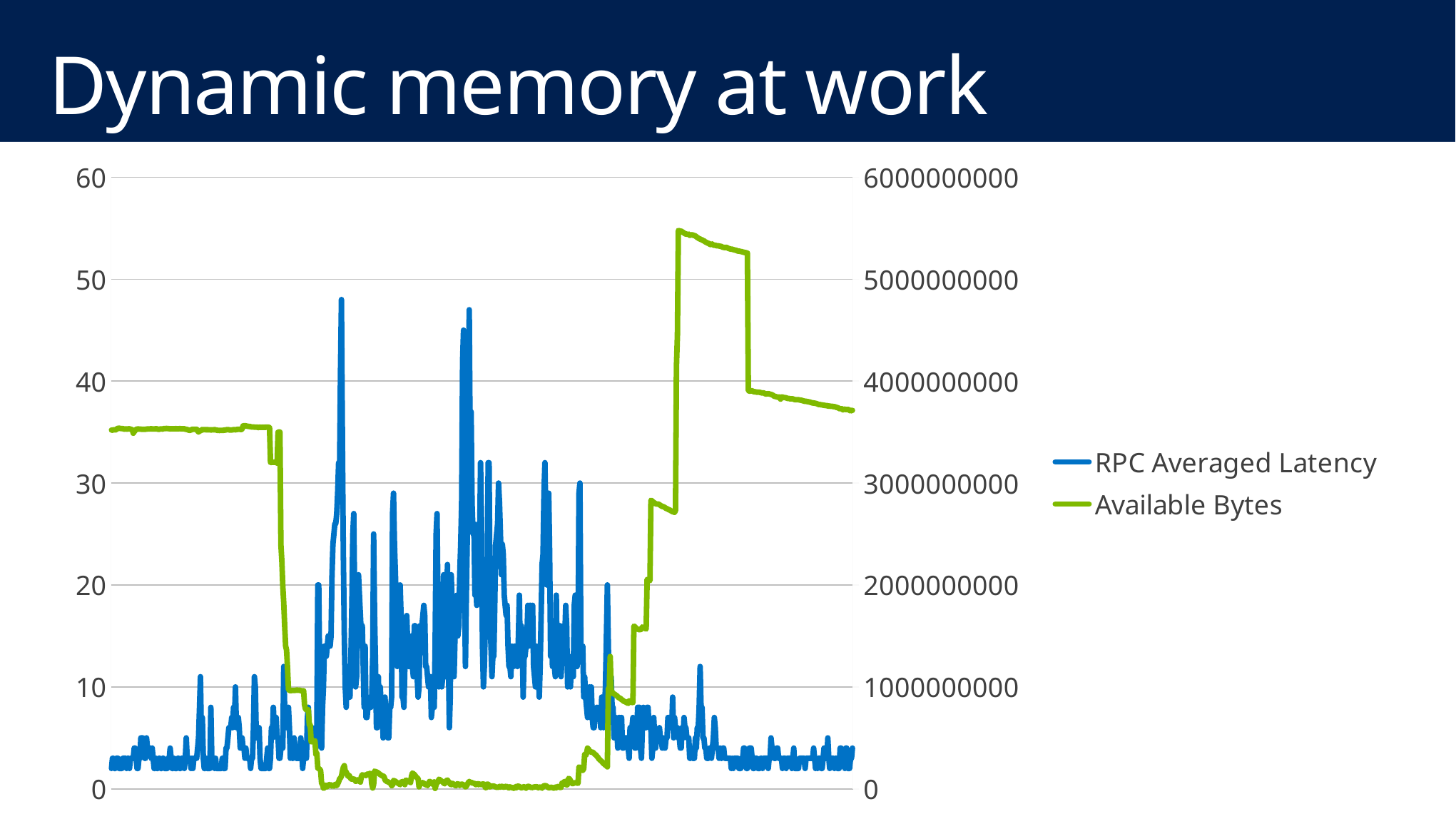
Is the highest value of RPC Averaged Latency greater or less than 50? less What is the maximum tick value on the left vertical axis? 60 What is the maximum tick value on the right vertical axis? 6000000000 Is the value of Available Bytes at the far right end of the chart greater or less than 3000000000? greater What is the title of the slide containing the chart? Dynamic memory at work Is the value of Available Bytes at the far left start of the chart greater or less than 4000000000? less What kind of chart is shown on the slide? line chart Which series is drawn in green? Available Bytes How many series does the legend list? 2